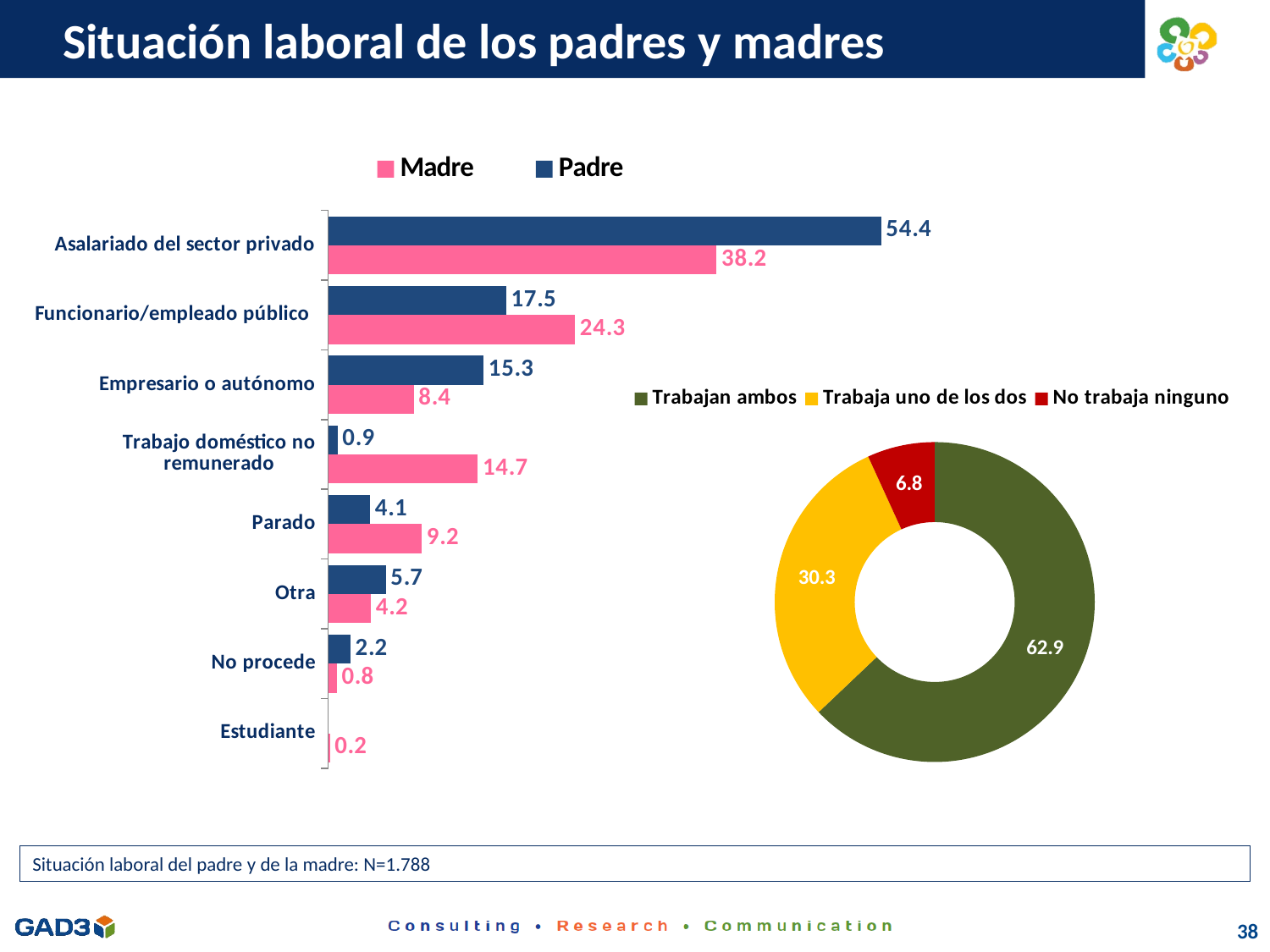
In the donut chart on the right, what is the value for Trabaja uno de los dos? 30.3 In the bar chart on the left, which category has the highest Madre value? Asalariado del sector privado How many slices does the donut chart on the right have? 3 In the bar chart on the left, what is the Madre value for Funcionario/empleado público? 24.3 In the donut chart on the right, which slice is the largest? Trabajan ambos What kind of chart is the chart on the left? Bar chart In the bar chart on the left, what is the Madre value for Trabajo doméstico no remunerado? 14.7 In the bar chart on the left, what is the difference between the Padre and Madre values for Asalariado del sector privado? 16.2 In the bar chart on the left, which category has the lowest Padre value? Trabajo doméstico no remunerado In the bar chart on the left, what is the Padre value for Asalariado del sector privado? 54.4 How many series does the legend of the bar chart on the left list? 2 In the bar chart on the left, which is larger for Parado: the Madre value or the Padre value? Madre